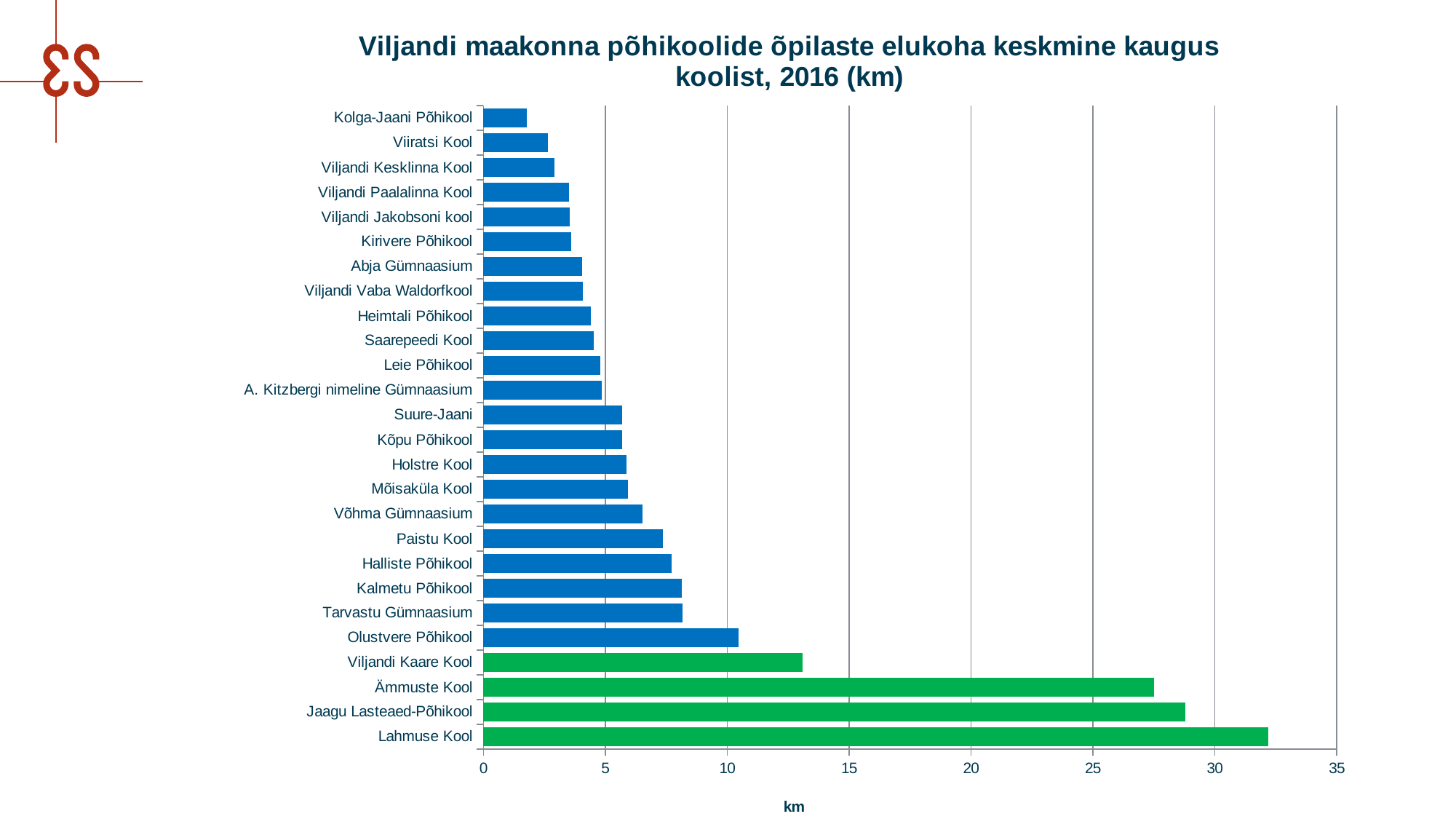
Which school has the shortest bar (smallest average distance)? Kolga-Jaani Põhikool Which is larger, the value for Lahmuse Kool or the value for Ämmuste Kool? Lahmuse Kool Which is larger, the value for Olustvere Põhikool or the value for Viljandi Kaare Kool? Viljandi Kaare Kool Is the value for Ämmuste Kool greater or less than 30? less Is the value for Lahmuse Kool greater or less than 30? greater How many bars are coloured green? 4 Which school has the longest bar (greatest average distance)? Lahmuse Kool Is the value for Tarvastu Gümnaasium greater or less than 10? less What kind of chart is shown on the slide? bar chart Do the bar values increase or decrease going from the top of the chart to the bottom? increase How many schools are listed on the chart? 26